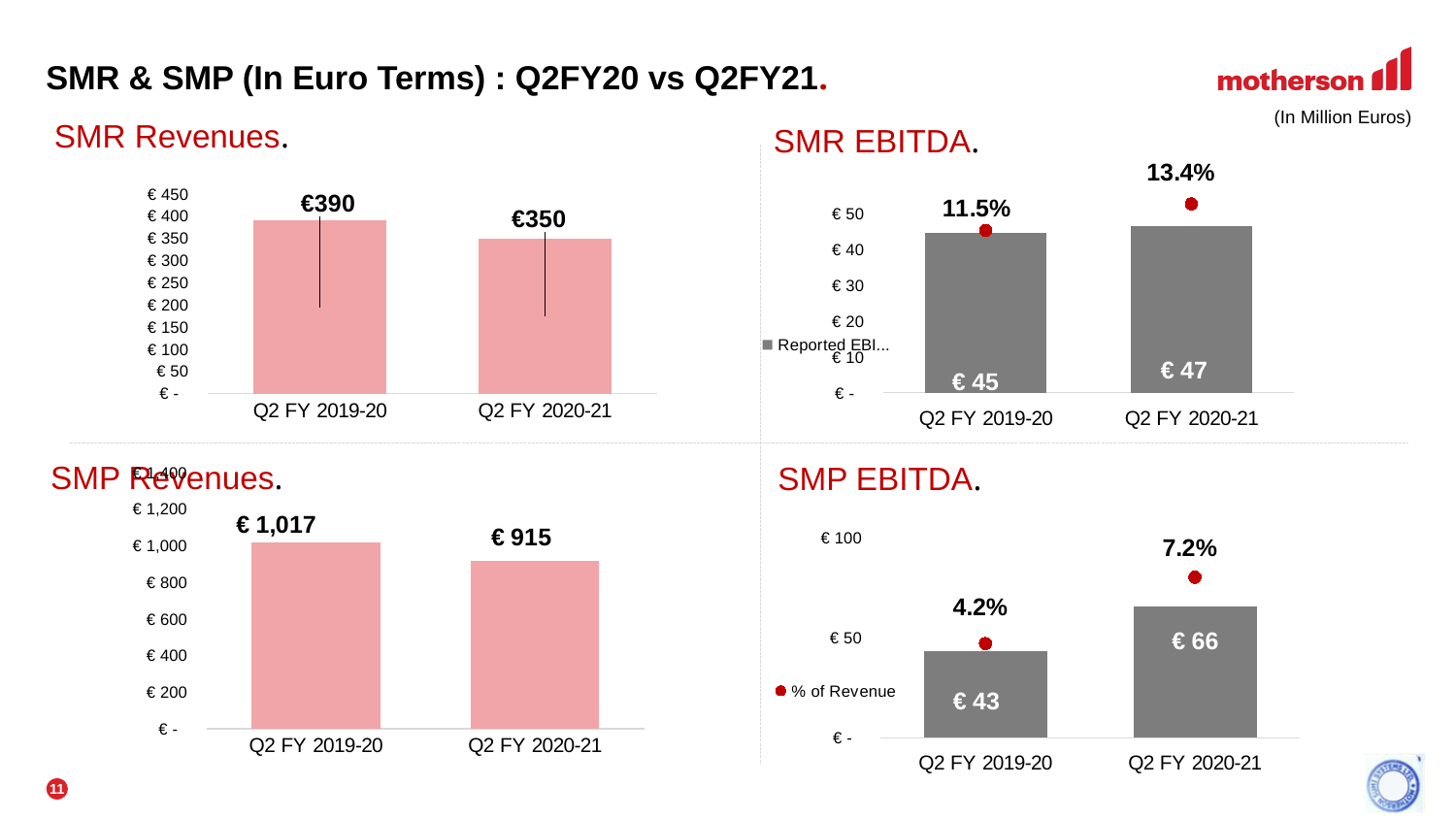
In the SMR EBITDA chart, what is the reported EBITDA for Q2 FY 2020-21? € 47 In the SMP Revenues chart, do revenues rise or fall from Q2 FY 2019-20 to Q2 FY 2020-21? fall In the SMR Revenues chart, what is the value for Q2 FY 2019-20? €390 In the SMR Revenues chart, what is the difference between the Q2 FY 2019-20 and Q2 FY 2020-21 values? €40 In the SMP Revenues chart, is the value for Q2 FY 2020-21 greater or less than € 1,000? less In the SMP EBITDA chart, what is the difference in EBITDA between Q2 FY 2020-21 and Q2 FY 2019-20? € 23 What type of chart is the SMP Revenues chart? bar chart In the SMP EBITDA chart, what is the EBITDA for Q2 FY 2020-21? € 66 In the SMR EBITDA chart, which quarter has the higher EBITDA margin? Q2 FY 2020-21 In the SMR Revenues chart, what is the value for Q2 FY 2020-21? €350 In the SMR EBITDA chart, what is the EBITDA percentage of revenue for Q2 FY 2019-20? 11.5% In the SMP Revenues chart, what is the value for Q2 FY 2019-20? € 1,017